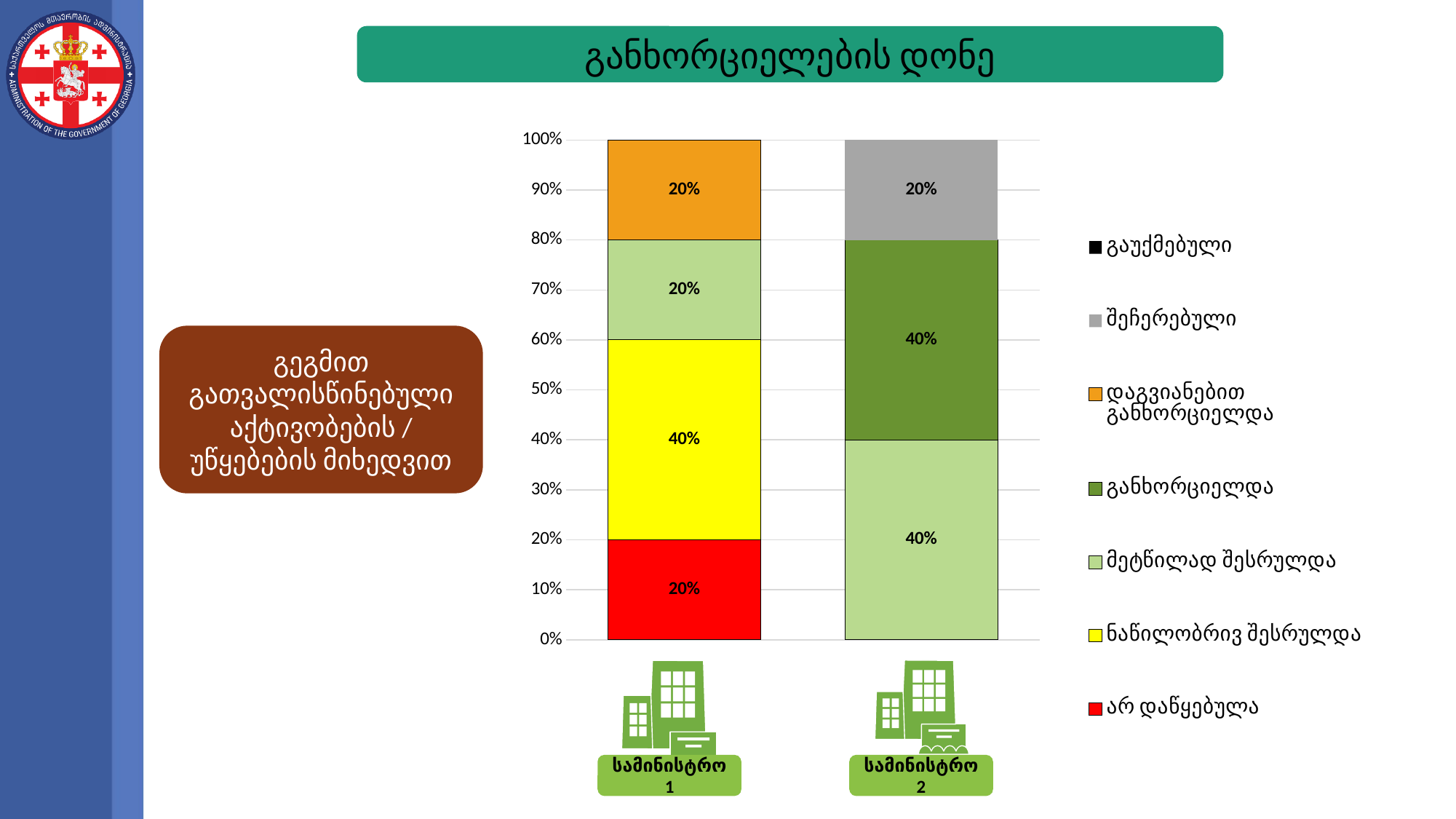
How many bars (categories) are plotted in the chart? 2 What is the title of the chart? განხორციელების დონე What is the difference between მეტწილად შესრულდა for სამინისტრო 2 and მეტწილად შესრულდა for სამინისტრო 1? 20% What is the value of არ დაწყებულა for სამინისტრო 1? 20% What is the value of დაგვიანებით განხორციელდა for სამინისტრო 1? 20% What kind of chart is shown on the slide? stacked bar chart Which is larger for სამინისტრო 2: მეტწილად შესრულდა or შეჩერებული? მეტწილად შესრულდა What is the value of განხორციელდა for სამინისტრო 2? 40% What is the value of შეჩერებული for სამინისტრო 2? 20% What is the value of ნაწილობრივ შესრულდა for სამინისტრო 1? 40% How many series does the legend list? 7 Which colour represents არ დაწყებულა in the legend? red